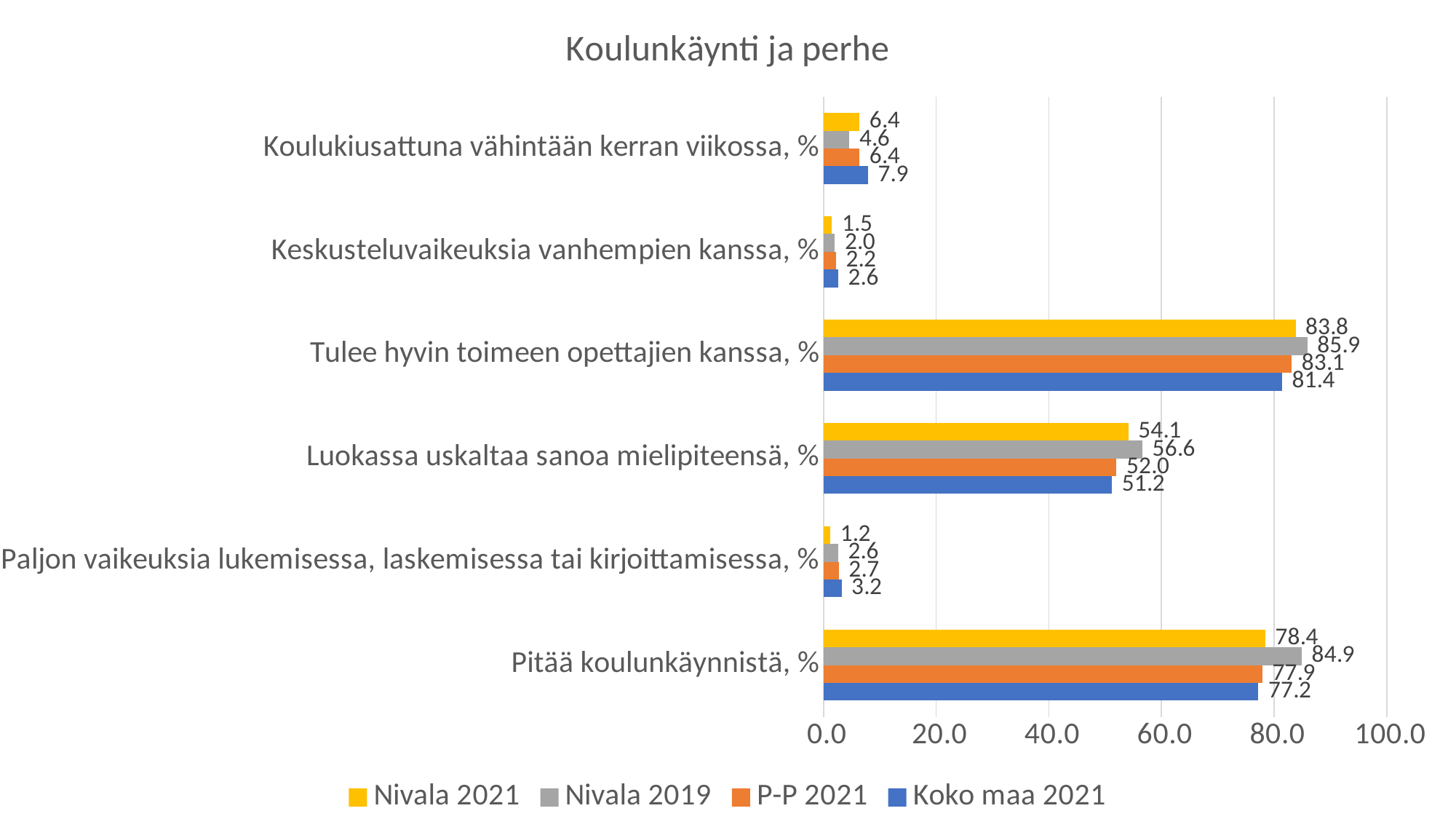
How many series does the legend list? 4 Which series has the highest value in the category "Tulee hyvin toimeen opettajien kanssa, %"? Nivala 2019 What is the value for Nivala 2019 in the category "Luokassa uskaltaa sanoa mielipiteensä, %"? 56.6 What is the title of the chart? Koulunkäynti ja perhe What is the difference between Nivala 2019 and Nivala 2021 in the category "Pitää koulunkäynnistä, %"? 6.5 What kind of chart is shown on the slide? Bar chart What is the value for Koko maa 2021 in the category "Koulukiusattuna vähintään kerran viikossa, %"? 7.9 How many categories are shown on the chart? 6 What is the value for Nivala 2021 in the category "Pitää koulunkäynnistä, %"? 78.4 Which series has the lowest value in the category "Paljon vaikeuksia lukemisessa, laskemisessa tai kirjoittamisessa, %"? Nivala 2021 Which is larger in the category "Keskusteluvaikeuksia vanhempien kanssa, %": P-P 2021 or Koko maa 2021? Koko maa 2021 What colour represents the Koko maa 2021 series? Blue